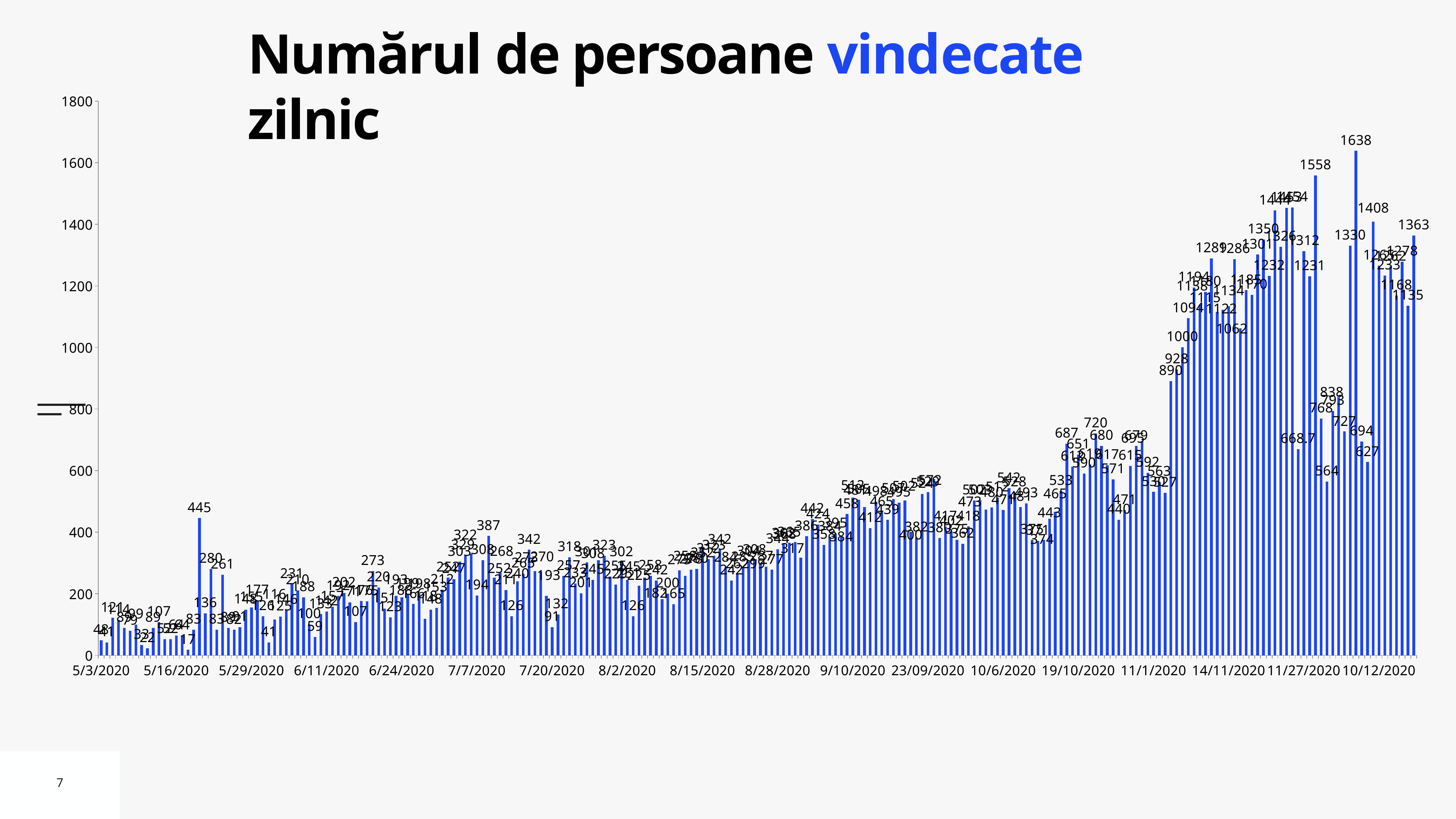
What kind of chart is shown on the slide? bar chart What is the maximum value shown on the vertical axis? 1800 Is the value of the first bar at 5/3/2020 greater or less than 200? less What is the value of the tall spike in May 2020, shortly after 5/16/2020? 445 What is the value of the last bar on the right of the chart? 1363 Overall, do the daily values rise or fall from left to right along the x axis? rise What is the difference between the two highest labelled values, 1638 and 1558? 80 What is the highest daily value shown in the chart? 1638 What is the title of the chart? Numărul de persoane vindecate zilnic What is the second-highest labelled value in the chart? 1558 Which is larger: the May spike of 445 or the early-July peak of 387? 445 What is the value of the first bar, at 5/3/2020? 48